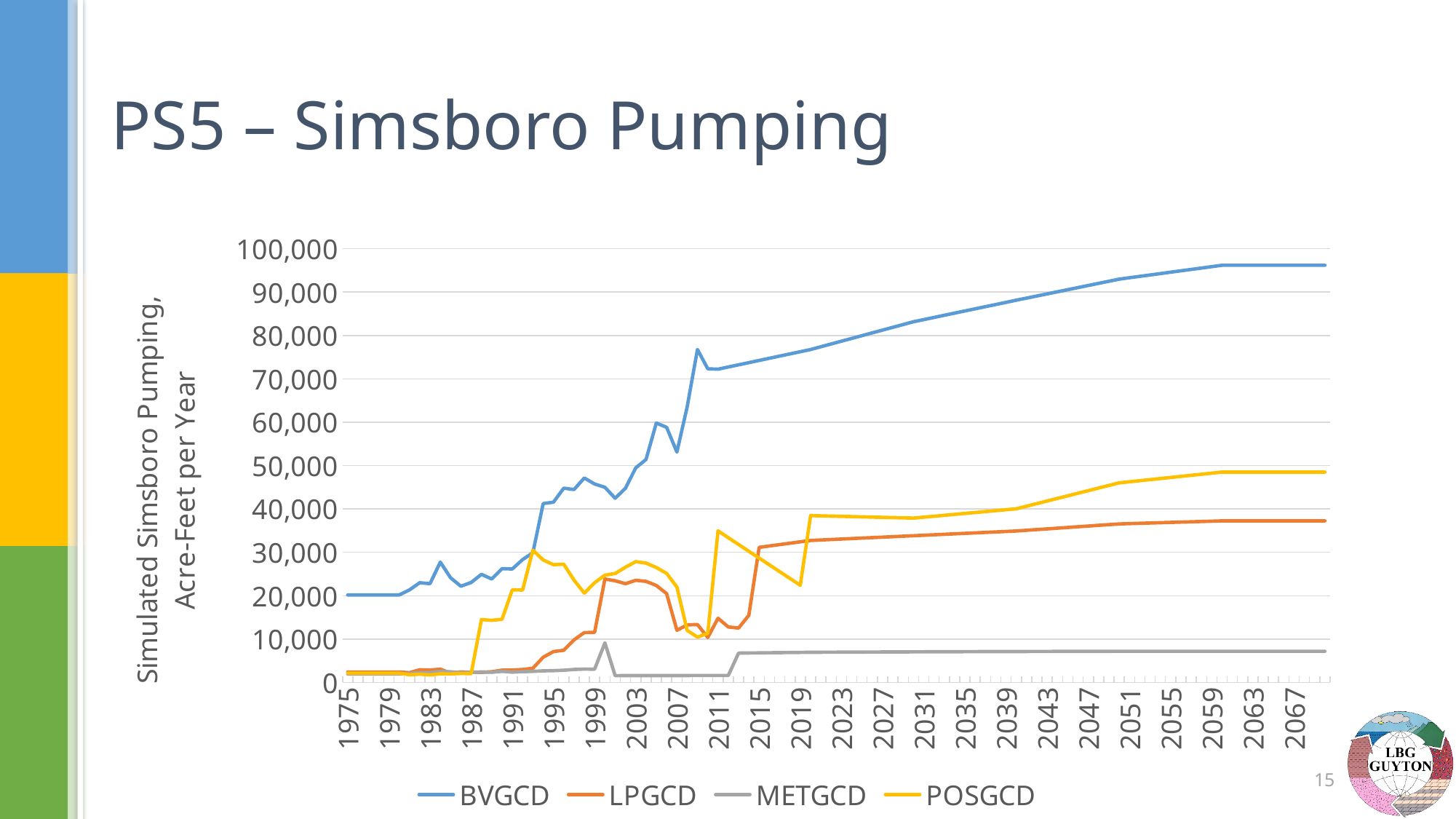
What kind of chart is shown on the slide? line chart Is the value for BVGCD in 1975 greater or less than 30,000? less Which series has the highest pumping values at the right end of the chart (2067)? BVGCD How many series does the legend list? 4 Is the value for BVGCD in 2067 greater or less than 90,000? greater In 2067, which series has the larger value, LPGCD or POSGCD? POSGCD Is the value for METGCD in 2067 greater or less than 10,000? less What is the label on the vertical axis of the chart? Simulated Simsboro Pumping, Acre-Feet per Year Does the BVGCD series generally rise or fall between 2015 and 2059? rise Which series has the lowest pumping values at the right end of the chart (2067)? METGCD